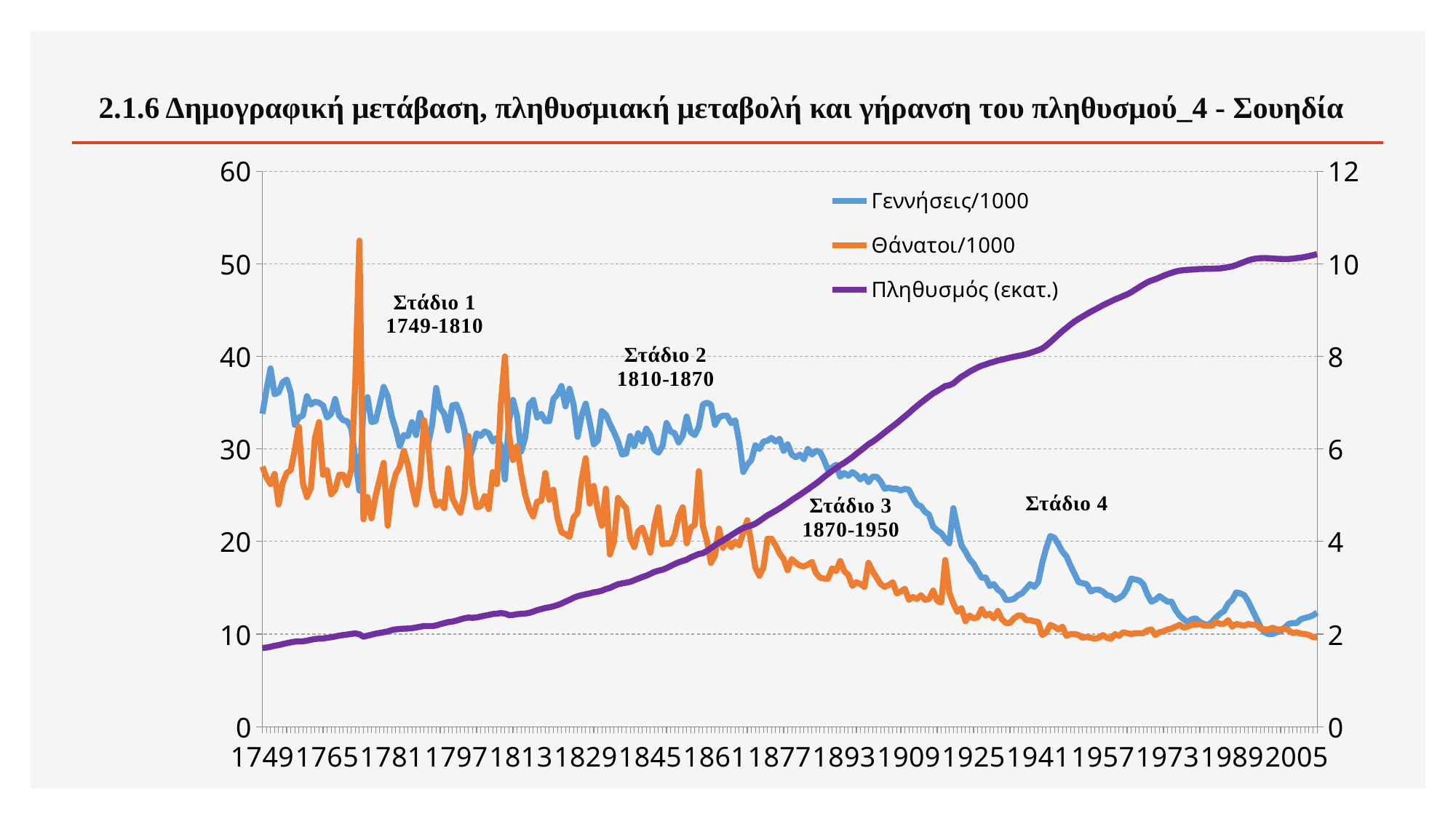
At 1749, which is larger: Γεννήσεις/1000 or Θάνατοι/1000? Γεννήσεις/1000 Is the value of Θάνατοι/1000 at 2005 greater or less than 20? less What is the title of the slide? 2.1.6 Δημογραφική μετάβαση, πληθυσμιακή μεταβολή και γήρανση του πληθυσμού_4 - Σουηδία How many series does the legend list? 3 Is the value of Πληθυσμός (εκατ.) at 2005 greater or less than 8 on the right axis? greater Is the value of Γεννήσεις/1000 at 1749 greater or less than 30? greater Does the Πληθυσμός (εκατ.) series rise or fall from 1749 to 2005? rise Does the Γεννήσεις/1000 series rise or fall overall from 1749 to 2005? fall Which series is plotted in purple? Πληθυσμός (εκατ.) What kind of chart is shown on the slide? line chart